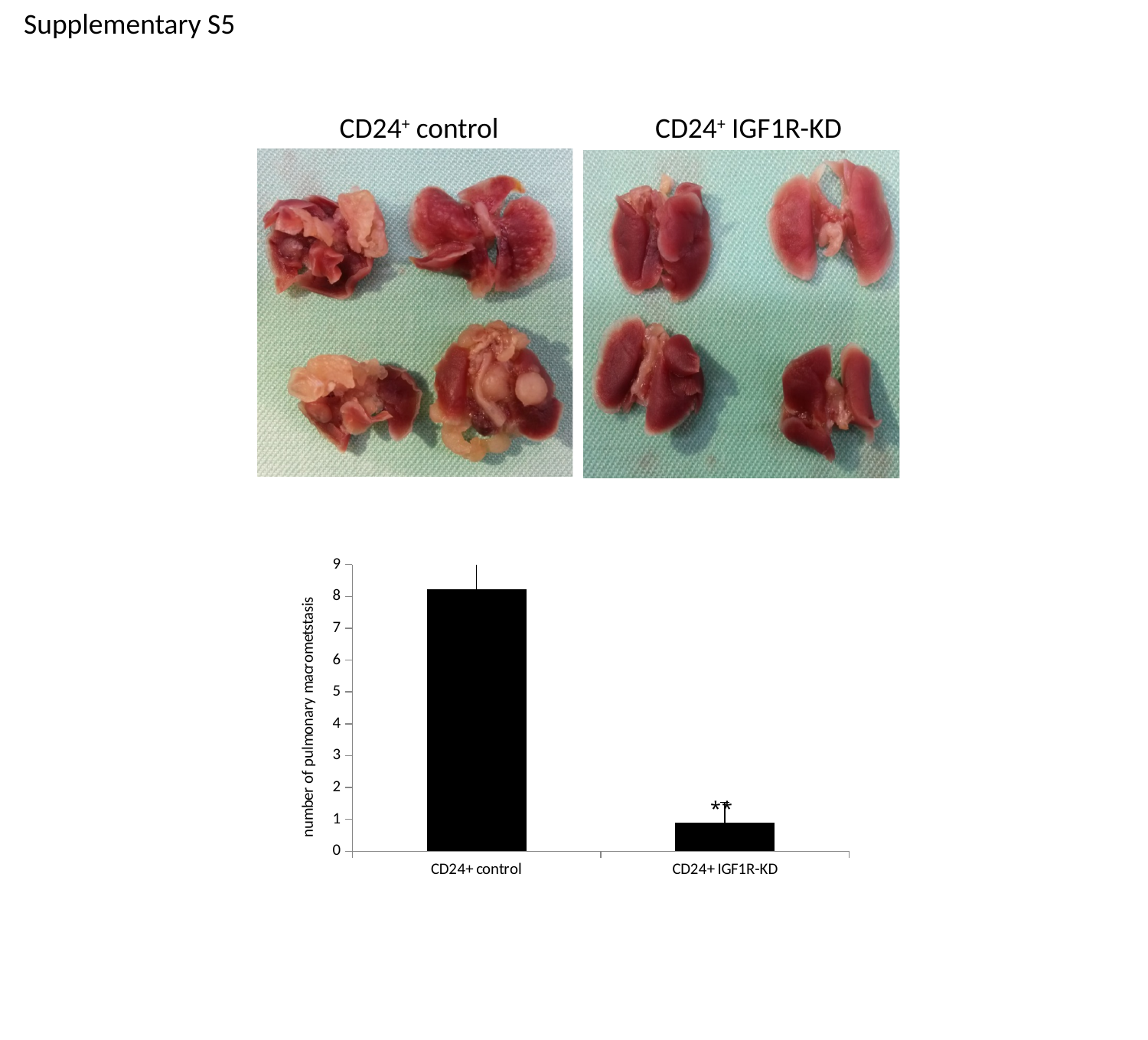
Which category has the highest number of pulmonary macrometastasis in the bar chart? CD24+ control What is the maximum value shown on the y axis of the bar chart? 9 What is the label on the y axis of the bar chart? number of pulmonary macrometstasis Is the value for CD24+ control in the bar chart greater or less than 5? greater Is the value for CD24+ control in the bar chart greater or less than 7? greater Which category has the lowest number of pulmonary macrometastasis in the bar chart? CD24+ IGF1R-KD What kind of chart is shown on the slide? bar chart Which is larger in the bar chart, the value for CD24+ control or the value for CD24+ IGF1R-KD? CD24+ control How many categories are shown on the x axis of the bar chart? 2 Is the value for CD24+ IGF1R-KD in the bar chart greater or less than 2? less